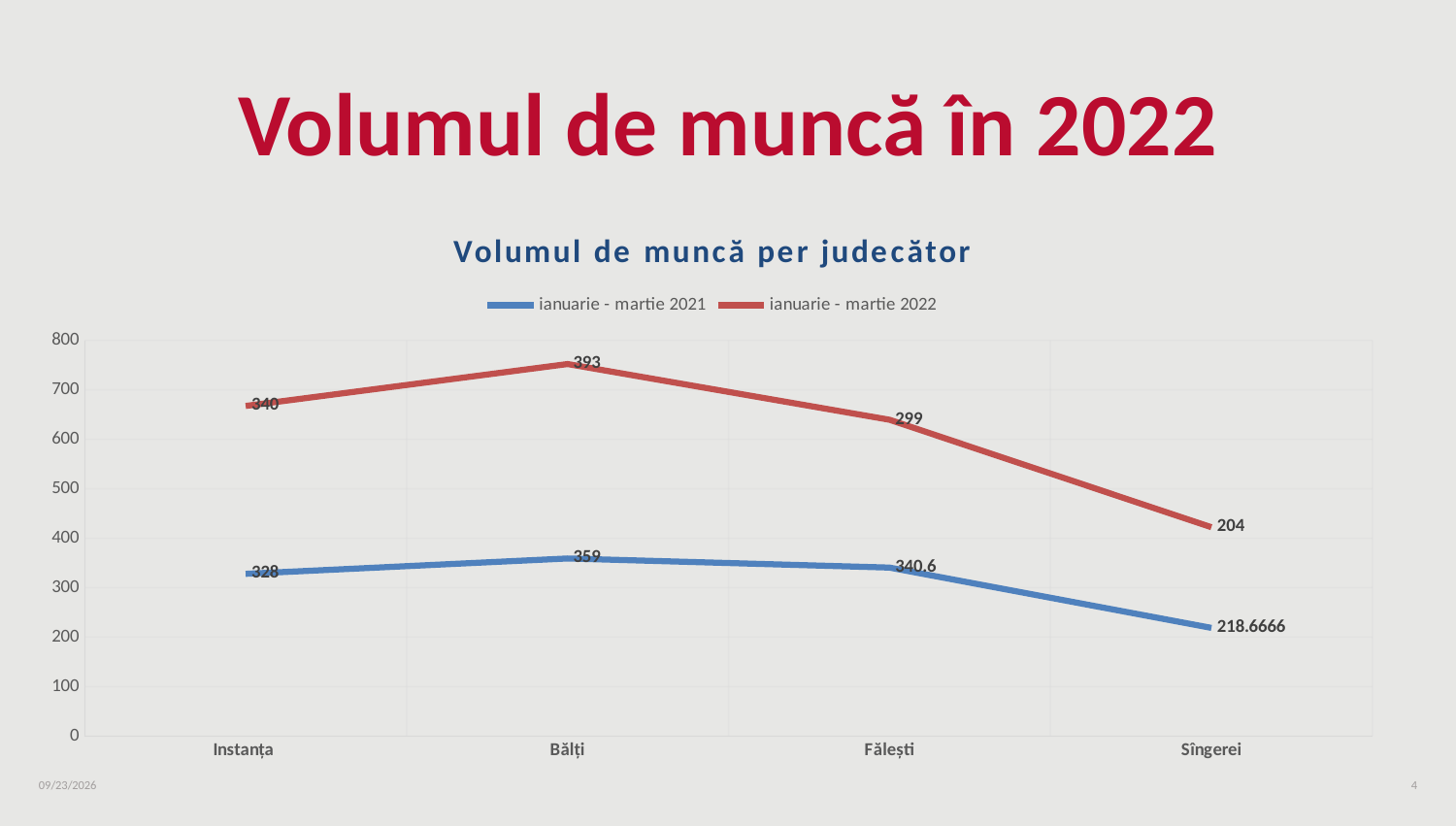
How many series does the legend list? 2 What is the value for Bălți in the ianuarie - martie 2022 series? 393 What kind of chart is shown on the slide? line chart What is the value for Sîngerei in the ianuarie - martie 2021 series? 218.6666 Which category has the highest value in the ianuarie - martie 2022 series? Bălți What is the value for Instanța in the ianuarie - martie 2021 series? 328 What is the difference between the ianuarie - martie 2022 and ianuarie - martie 2021 values for Bălți? 34 Which category has the lowest value in the ianuarie - martie 2021 series? Sîngerei What is the difference between the ianuarie - martie 2022 and ianuarie - martie 2021 values for Instanța? 12 For Bălți, which series has the larger value, ianuarie - martie 2021 or ianuarie - martie 2022? ianuarie - martie 2022 What is the value for Fălești in the ianuarie - martie 2022 series? 299 How many categories are shown on the x axis? 4